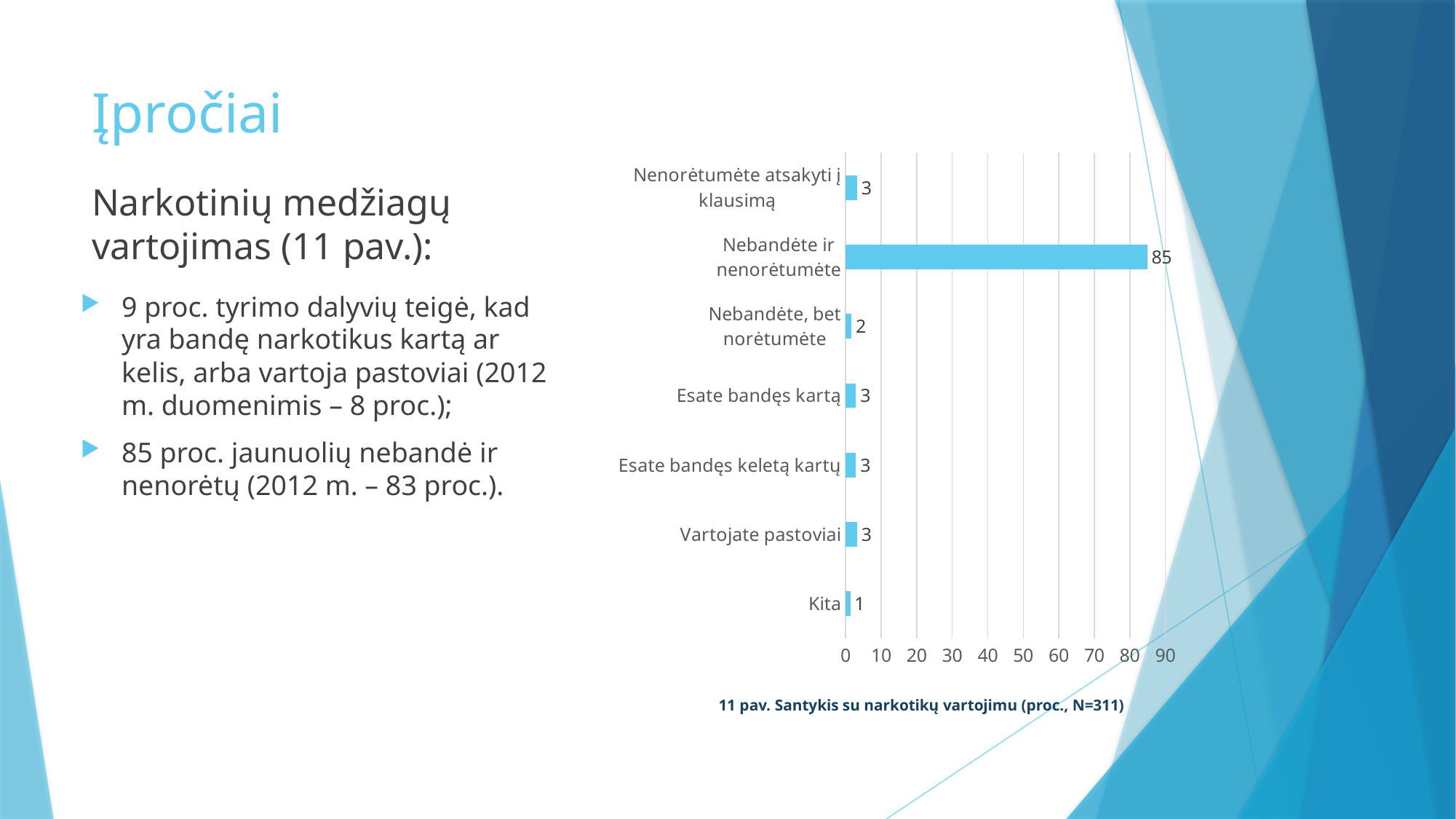
What kind of chart is shown on the slide? bar chart Which is larger, the value for "Nebandėte, bet norėtumėte" or the value for "Esate bandęs keletą kartų"? Esate bandęs keletą kartų What is the value for "Nebandėte, bet norėtumėte"? 2 What is the value for "Vartojate pastoviai"? 3 Which category has the highest value? Nebandėte ir nenorėtumėte Is the value for "Nebandėte ir nenorėtumėte" greater or less than 80? greater What is the value for "Nebandėte ir nenorėtumėte"? 85 Which category has the lowest value? Kita What is the caption of the chart? 11 pav. Santykis su narkotikų vartojimu (proc., N=311) What is the difference between the values for "Nebandėte ir nenorėtumėte" and "Esate bandęs kartą"? 82 What is the value for "Kita"? 1 How many categories are shown in the chart? 7